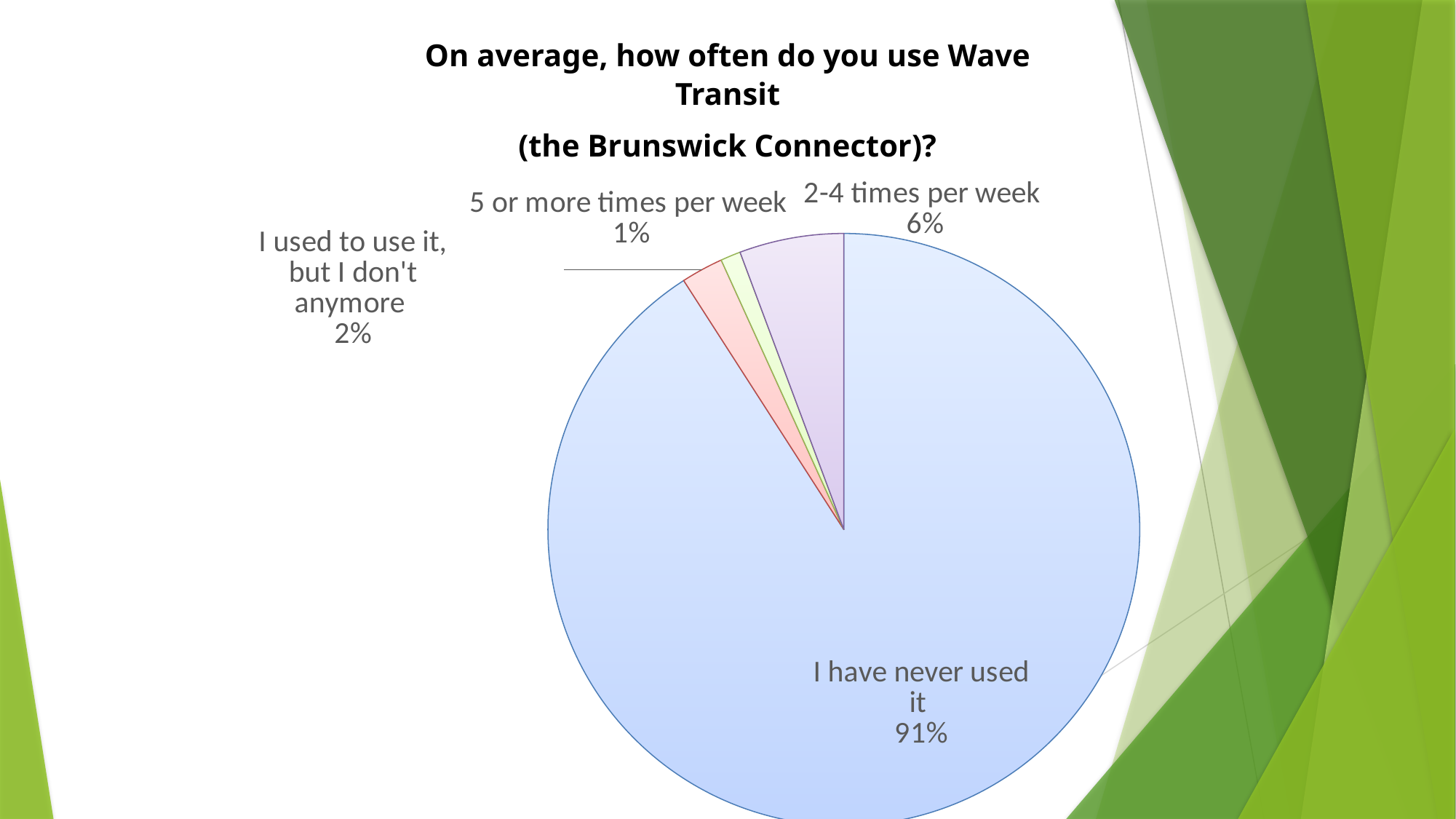
What percentage of respondents said they used to use it but don't anymore? 2% What kind of chart is shown on the slide? Pie chart Which is larger: the share for "2-4 times per week" or the share for "I used to use it, but I don't anymore"? 2-4 times per week What percentage of respondents said they have never used Wave Transit? 91% How many slices does the pie chart have? 4 Which category has the largest slice of the pie? I have never used it What is the difference in percentage points between "I used to use it, but I don't anymore" and "5 or more times per week"? 1 What percentage of respondents use Wave Transit 5 or more times per week? 1% What is the title of the chart? On average, how often do you use Wave Transit (the Brunswick Connector)? Which category has the smallest slice of the pie? 5 or more times per week What share of the pie is labelled "2-4 times per week"? 6% What is the difference in percentage points between "I have never used it" and "2-4 times per week"? 85